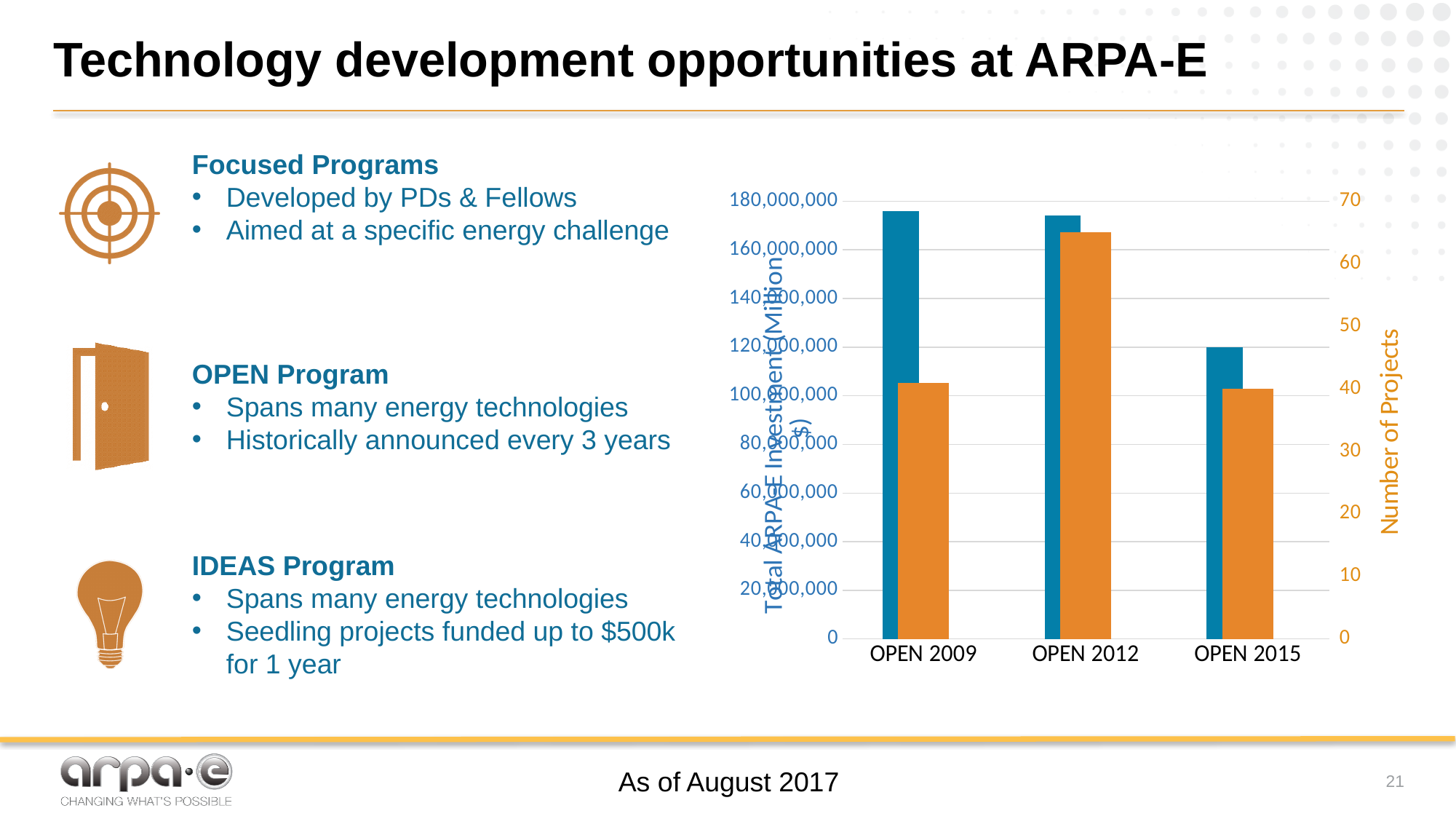
Is the Number of Projects for OPEN 2015 greater or less than 50? less Do the Total ARPA-E Investment bars rise or fall from OPEN 2009 to OPEN 2015? fall What is the title of the right-hand vertical axis of the chart? Number of Projects Is the Number of Projects for OPEN 2012 greater or less than 60? greater Which has a larger Number of Projects, OPEN 2012 or OPEN 2015? OPEN 2012 Is the Total ARPA-E Investment for OPEN 2009 greater or less than 160,000,000? greater What kind of chart is shown on the slide? bar chart How many OPEN program categories are shown on the x axis of the chart? 3 How many bars are plotted for each OPEN program category? 2 Which OPEN program has the highest Number of Projects (orange bar)? OPEN 2012 Which OPEN program has the lowest Total ARPA-E Investment (blue bar)? OPEN 2015